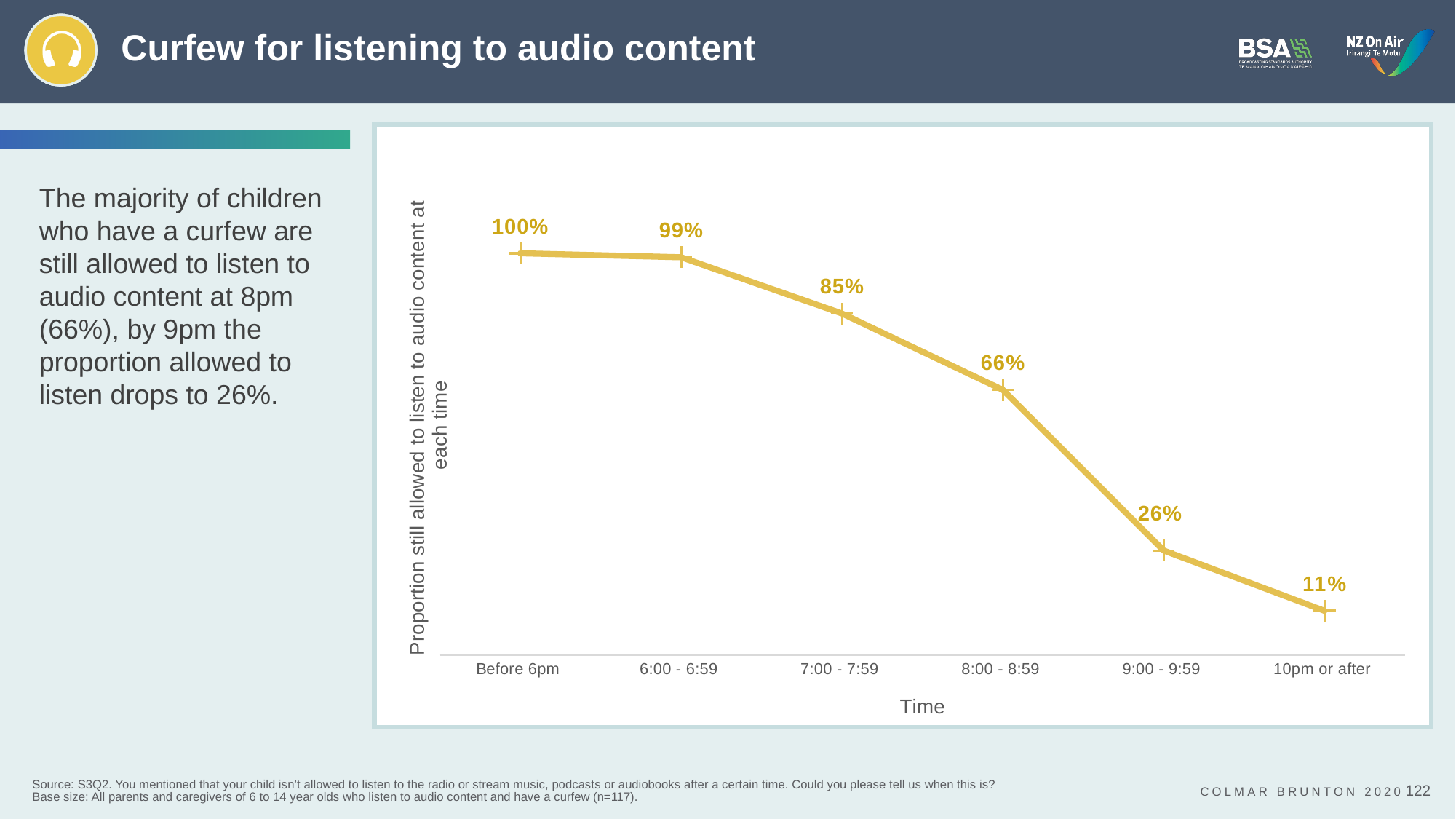
What is the difference between the values for 8:00 - 8:59 and 9:00 - 9:59? 40% What is the value for 7:00 - 7:59? 85% Do the values rise or fall as time moves from Before 6pm to 10pm or after? Fall What is the label of the x axis? Time Which time category has the highest value? Before 6pm What proportion of children are still allowed to listen to audio content at 8:00 - 8:59? 66% Which time category has the lowest value? 10pm or after What kind of chart is shown on the slide? Line chart How many time categories are shown on the x axis? 6 What is the value for 10pm or after? 11% Which is larger, the value for 7:00 - 7:59 or the value for 8:00 - 8:59? 7:00 - 7:59 What is the value for 9:00 - 9:59? 26%